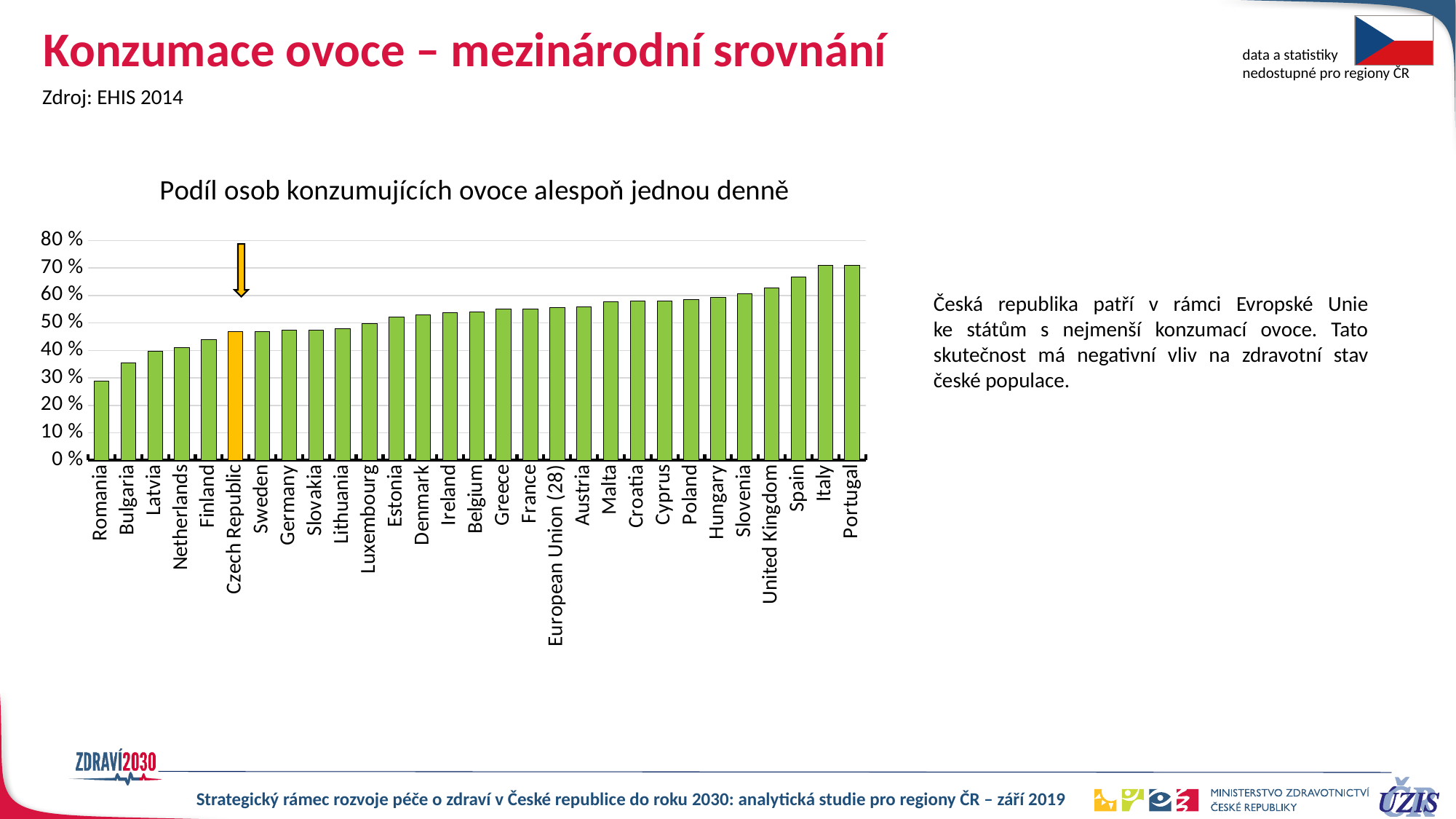
Is the value for Spain greater or less than 60 %? greater Which country has the lowest share of people consuming fruit at least once a day? Romania Which has a higher value, Romania or Bulgaria? Bulgaria Which country's bar is highlighted in orange instead of green? Czech Republic Which has a higher value, Czech Republic or Spain? Spain What kind of chart is shown on the slide? bar chart Is the value for Czech Republic greater or less than 50 %? less How many categories (countries/regions) are plotted on the x axis? 29 Is the value for Hungary greater or less than 50 %? greater Do the values rise or fall moving from left to right along the x axis? rise